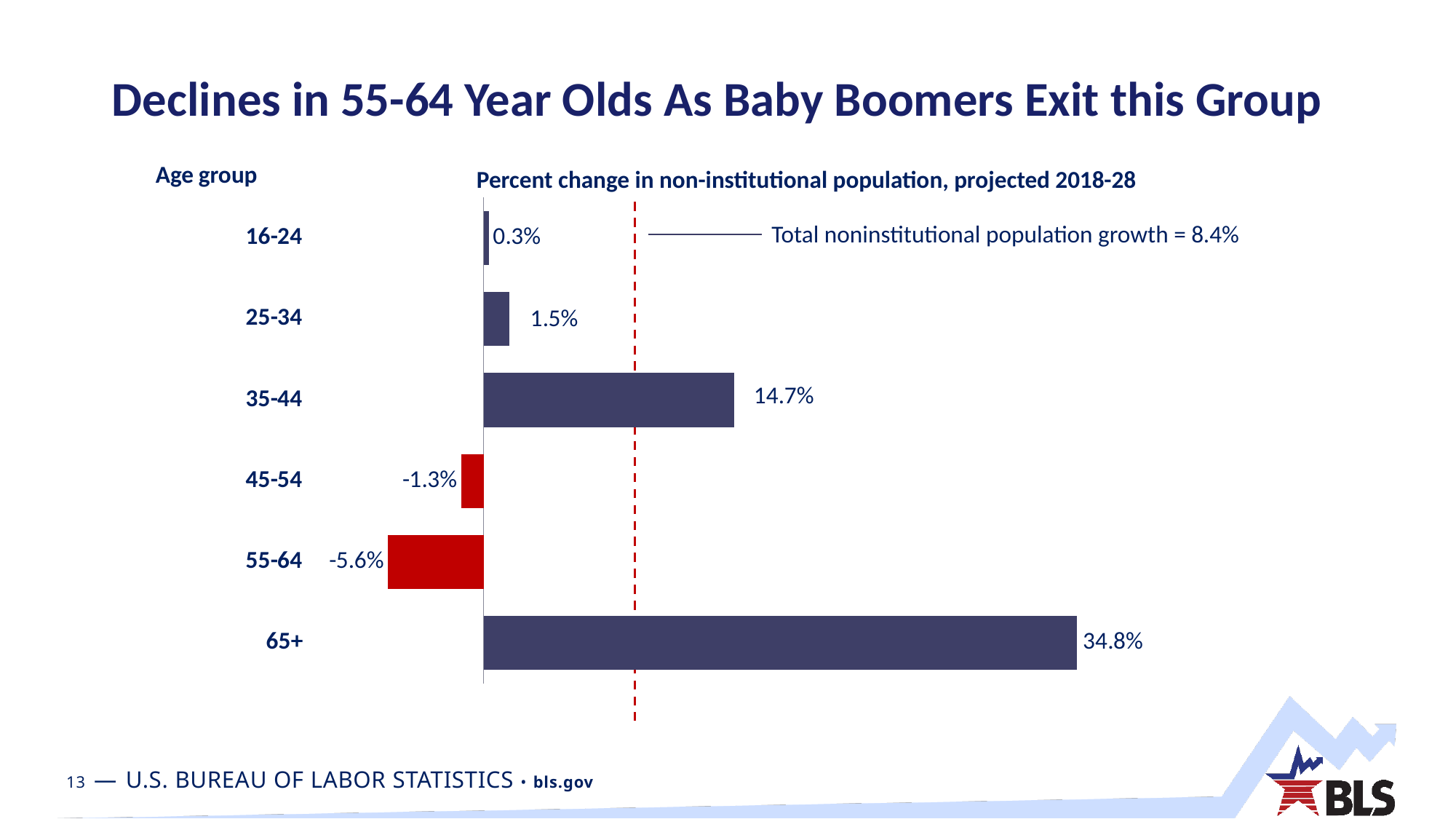
What is the projected percent change for the 16-24 age group? 0.3% What value does the dashed vertical line represent? Total noninstitutional population growth = 8.4% What is the projected percent change in non-institutional population for the 35-44 age group? 14.7% What is the projected percent change for the 55-64 age group? -5.6% Which age group has the highest projected percent change? 65+ How many age groups are shown in the chart? 6 Which has a larger projected percent change, the 25-34 group or the 45-54 group? 25-34 How many age groups show a negative projected percent change? 2 What colour are the bars for age groups with negative percent change? Red Which age group has the lowest projected percent change? 55-64 What is the difference between the projected percent change for 65+ and for 35-44? 20.1 percentage points What kind of chart is shown on the slide? Bar chart